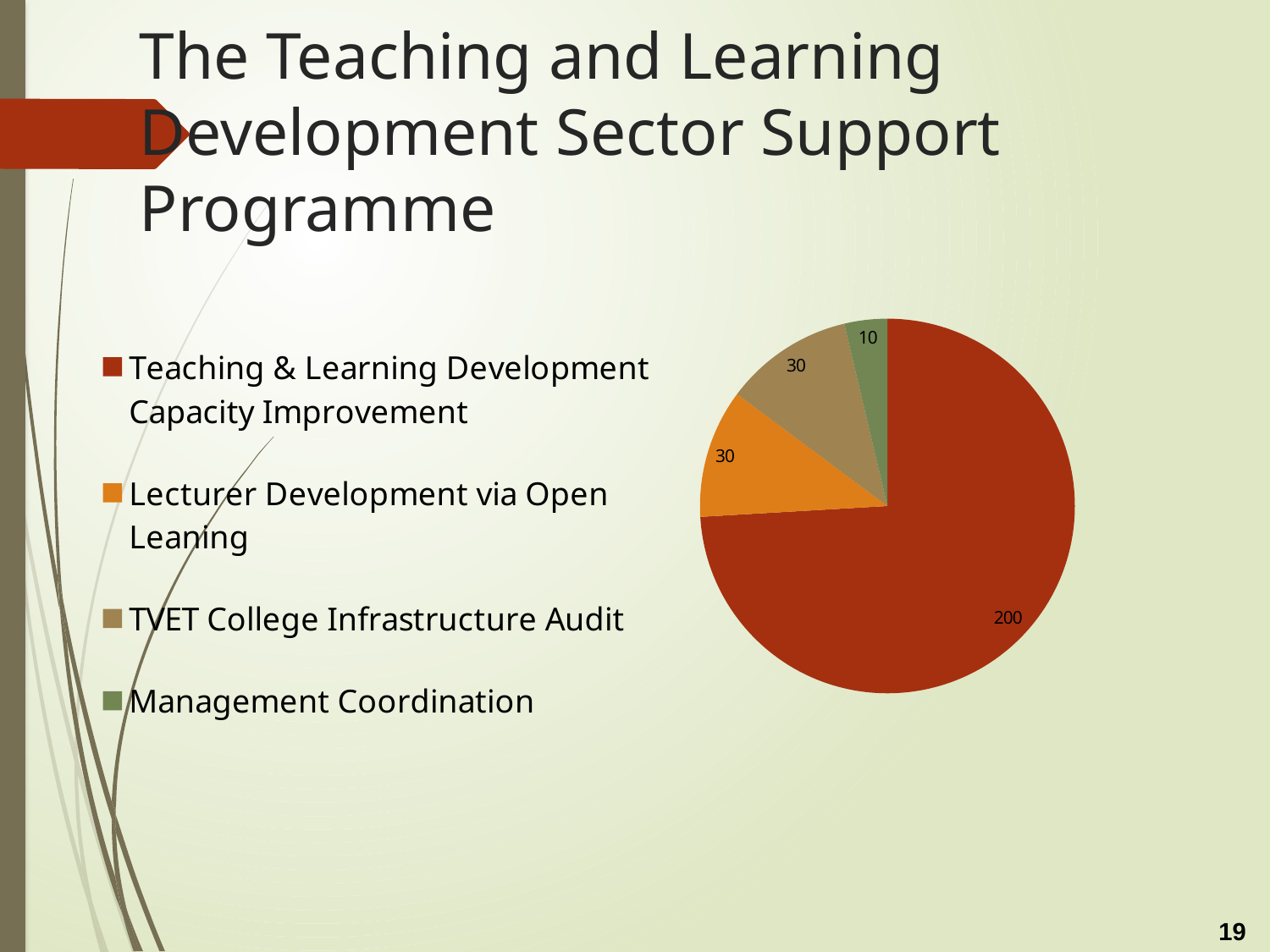
Which is larger, the TVET College Infrastructure Audit slice or the Management Coordination slice? TVET College Infrastructure Audit What is the total of all the values shown on the pie chart? 270 How many entries does the legend list? 4 What is the difference between the Teaching & Learning Development Capacity Improvement value and the Lecturer Development via Open Leaning value? 170 What value is shown for the TVET College Infrastructure Audit slice? 30 Which category has the largest slice of the pie? Teaching & Learning Development Capacity Improvement Which category has the smallest slice of the pie? Management Coordination How many slices does the pie chart have? 4 What kind of chart is shown on the slide? Pie chart What value is shown for the Teaching & Learning Development Capacity Improvement slice? 200 What is the difference between the TVET College Infrastructure Audit value and the Management Coordination value? 20 What value is shown for the Management Coordination slice? 10